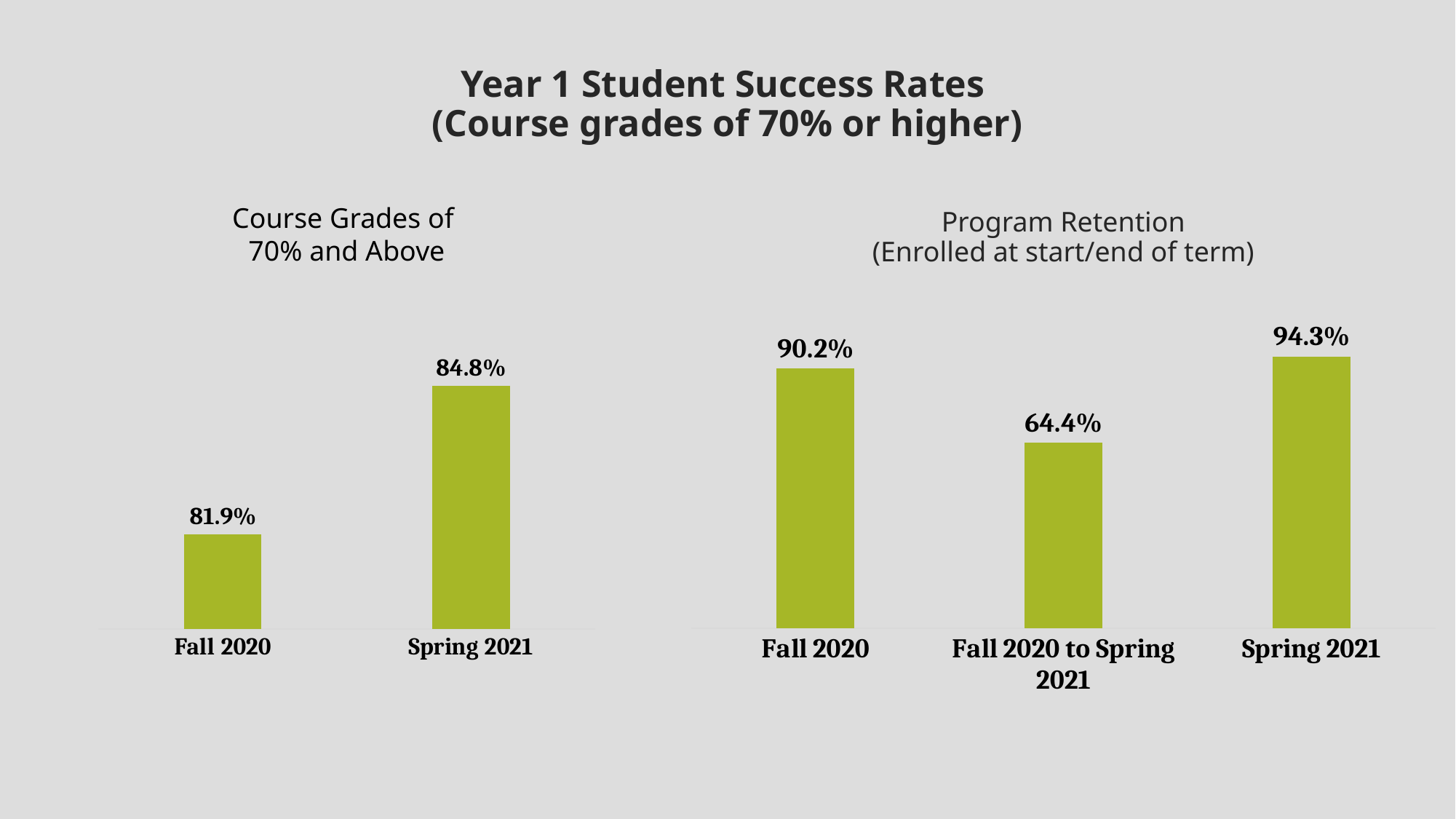
How many categories are shown in the 'Program Retention' chart? 3 In the 'Course Grades of 70% and Above' chart, what is the value for Spring 2021? 84.8% In the 'Program Retention' chart, which category has the lowest value? Fall 2020 to Spring 2021 In the 'Program Retention' chart, what is the difference between the Fall 2020 and Fall 2020 to Spring 2021 values? 25.8% What kind of chart is the 'Course Grades of 70% and Above' chart? Bar chart In the 'Program Retention' chart, what is the value for Fall 2020 to Spring 2021? 64.4% In the 'Course Grades of 70% and Above' chart, do the values rise or fall from Fall 2020 to Spring 2021? Rise In the 'Program Retention' chart, which category has the highest value? Spring 2021 In the 'Course Grades of 70% and Above' chart, what is the difference between the Spring 2021 and Fall 2020 values? 2.9% In the 'Course Grades of 70% and Above' chart, what is the value for Fall 2020? 81.9% In the 'Program Retention' chart, which is larger: the value for Fall 2020 or the value for Spring 2021? Spring 2021 In the 'Program Retention' chart, what is the value for Spring 2021? 94.3%